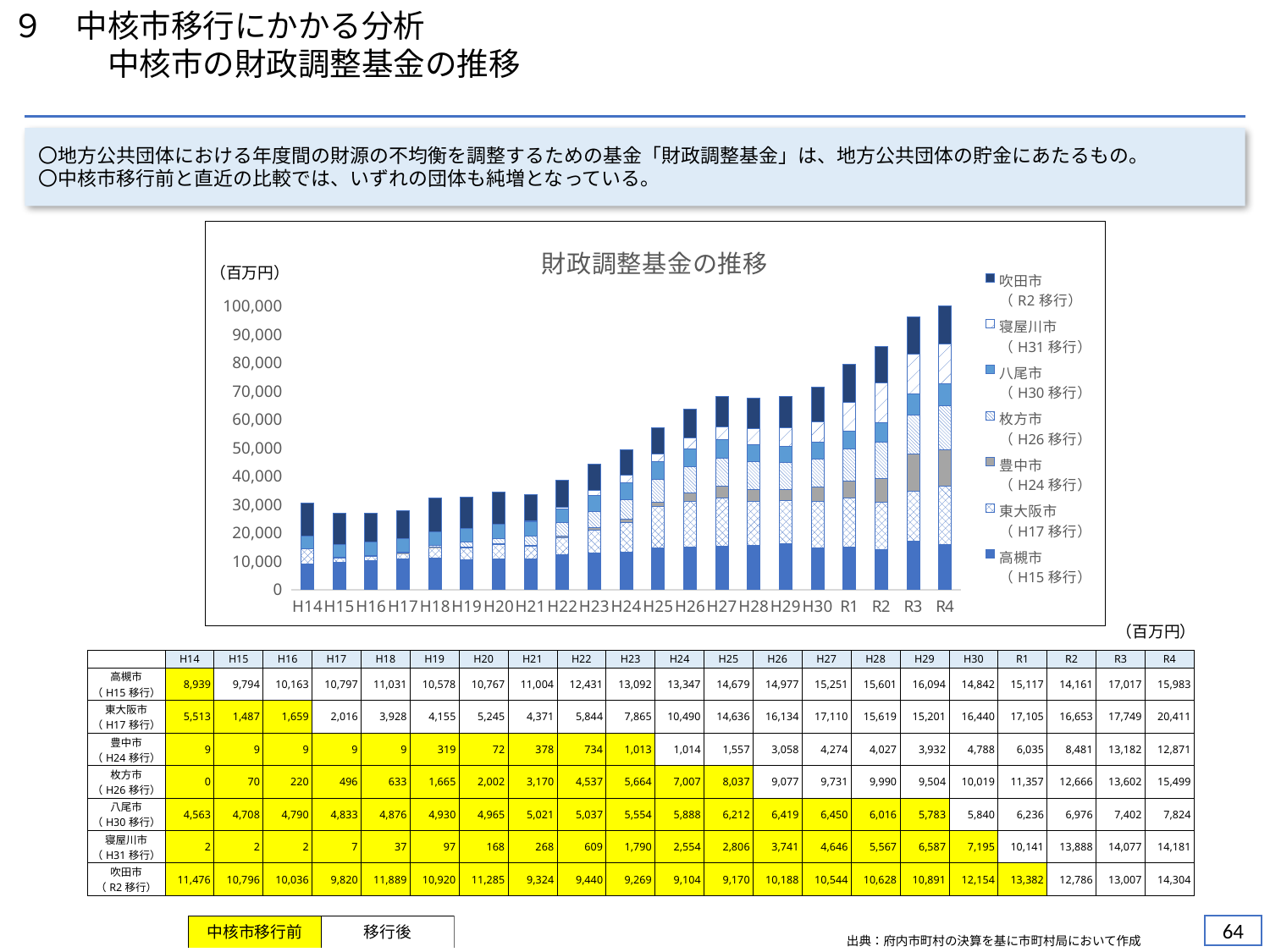
Which city has the highest value in R4? 東大阪市 What kind of chart is shown on the slide? stacked bar chart Which city has the lowest value in R4? 八尾市 What is the total of the stacked bar for R4? 101,073 What is the difference between the R4 and H14 values for 東大阪市? 14,898 How many fiscal-year categories are plotted along the x axis of the chart? 21 How many series does the chart legend list? 7 Does the total height of the stacked bars rise or fall from H14 to R4? rise Which is larger in R4, the value for 高槻市 or the value for 吹田市? 高槻市 What is the title of the chart? 財政調整基金の推移 What is the value for 高槻市 in H14? 8,939 What is the value for 東大阪市 in R4? 20,411